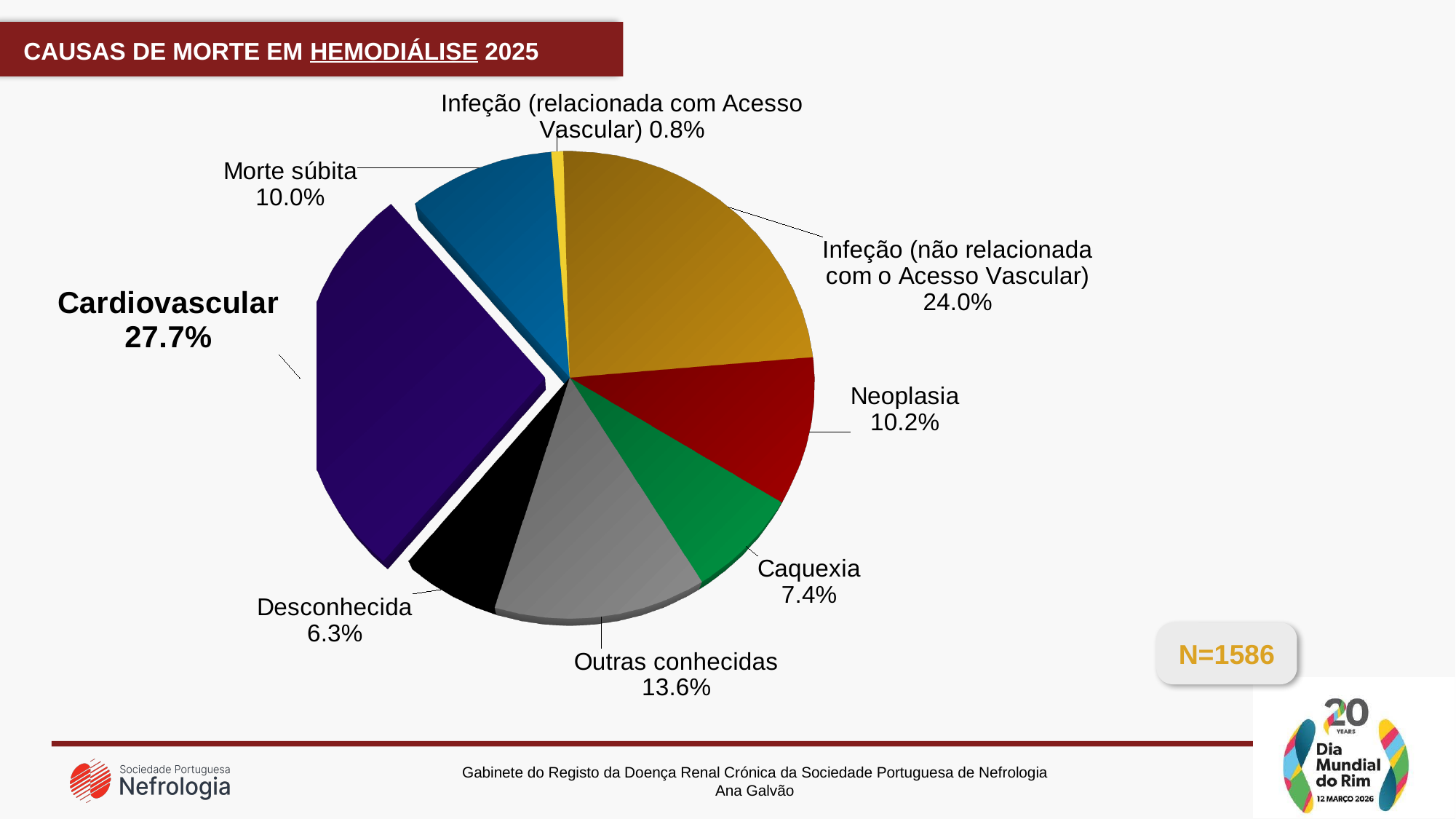
Which cause of death has the smallest slice of the pie? Infeção (relacionada com Acesso Vascular) Which cause of death has the largest slice of the pie? Cardiovascular What is the difference in percentage points between Cardiovascular and Infeção (não relacionada com o Acesso Vascular)? 3.7 What is the share for Infeção (relacionada com Acesso Vascular)? 0.8% How many slices does the pie chart have? 8 What kind of chart is shown on the slide? Pie chart Which is larger, the share for Caquexia or the share for Desconhecida? Caquexia What is the title of the slide? CAUSAS DE MORTE EM HEMODIÁLISE 2025 What is the value of N shown on the slide? N=1586 What is the share for Neoplasia? 10.2% What is the share for Cardiovascular? 27.7% What is the share for Outras conhecidas? 13.6%